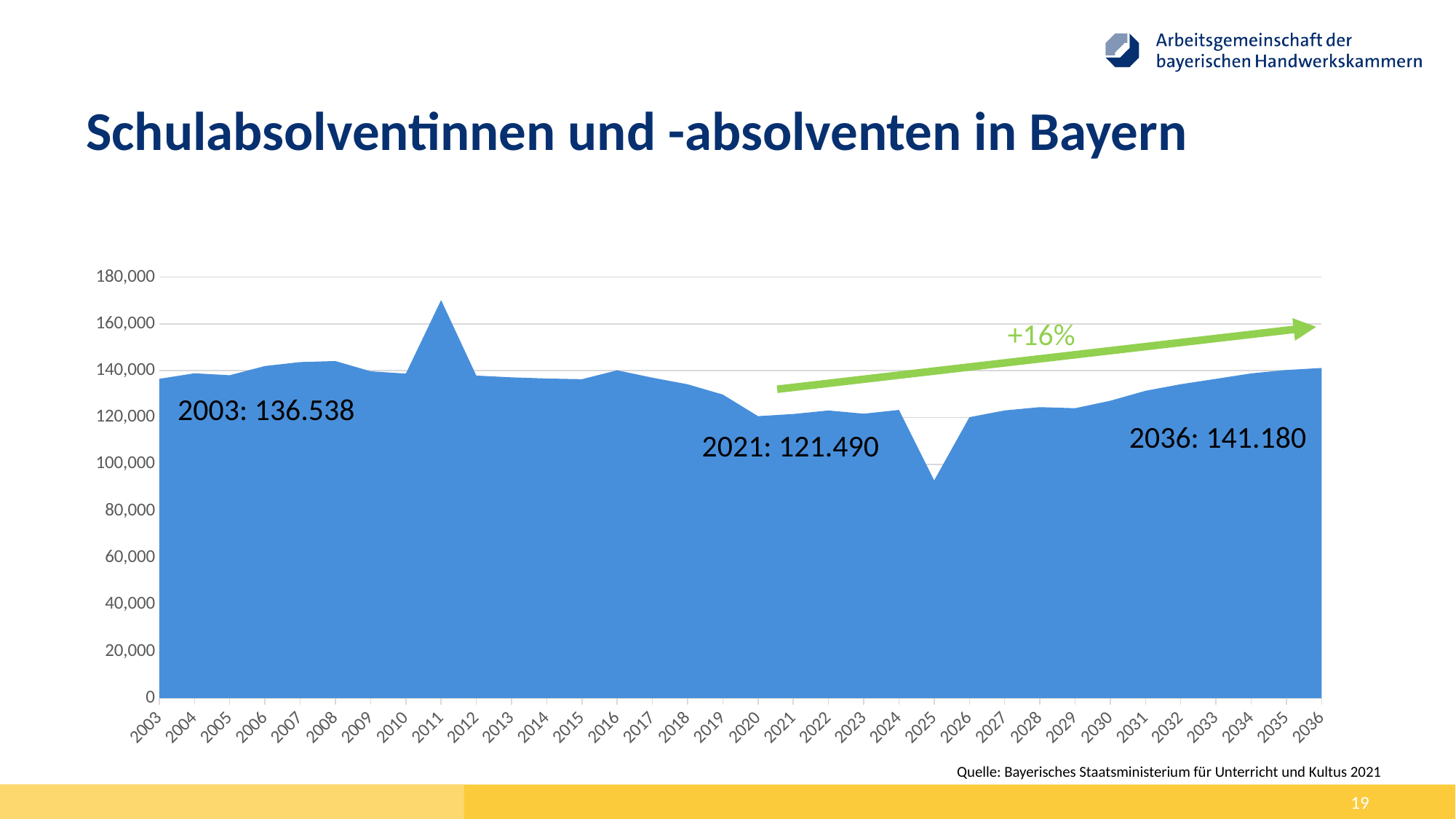
What kind of chart is shown on the slide? area chart How many years are shown on the x axis? 34 What is the value shown for 2021? 121.490 What is the difference between the labelled values for 2003 and 2021? 15.048 Which year has the larger labelled value, 2003 or 2036? 2036 Is the value for 2011 greater or less than 160,000? greater In which year does the chart reach its highest value? 2011 What is the difference between the labelled values for 2036 and 2021? 19.690 In which year does the chart reach its lowest value? 2025 Is the value for 2025 greater or less than 100,000? less What is the value shown for 2036? 141.180 What is the value shown for 2003? 136.538